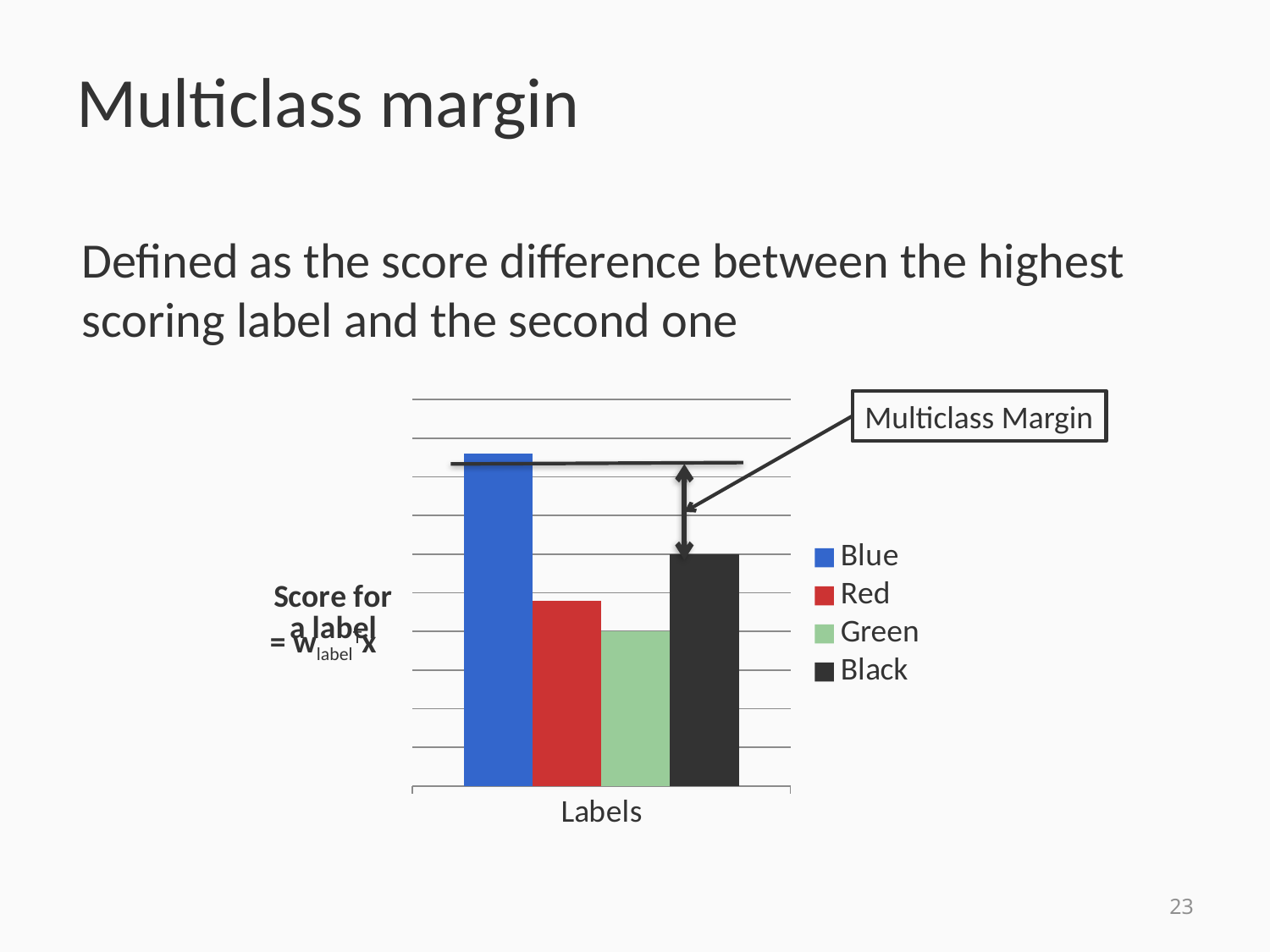
Which bar is shorter, Red or Green? Green How many bars are plotted in the chart? 4 What text is in the boxed annotation pointing to the arrow between the Blue and Black bars? Multiclass Margin Which series has the highest bar? Blue What kind of chart is shown on the slide? bar chart Which series has the second highest bar? Black Which bar is taller, Black or Red? Black Which series has the lowest bar? Green What is the title of the horizontal axis? Labels Which bar is taller, Blue or Black? Blue How many series does the legend list? 4